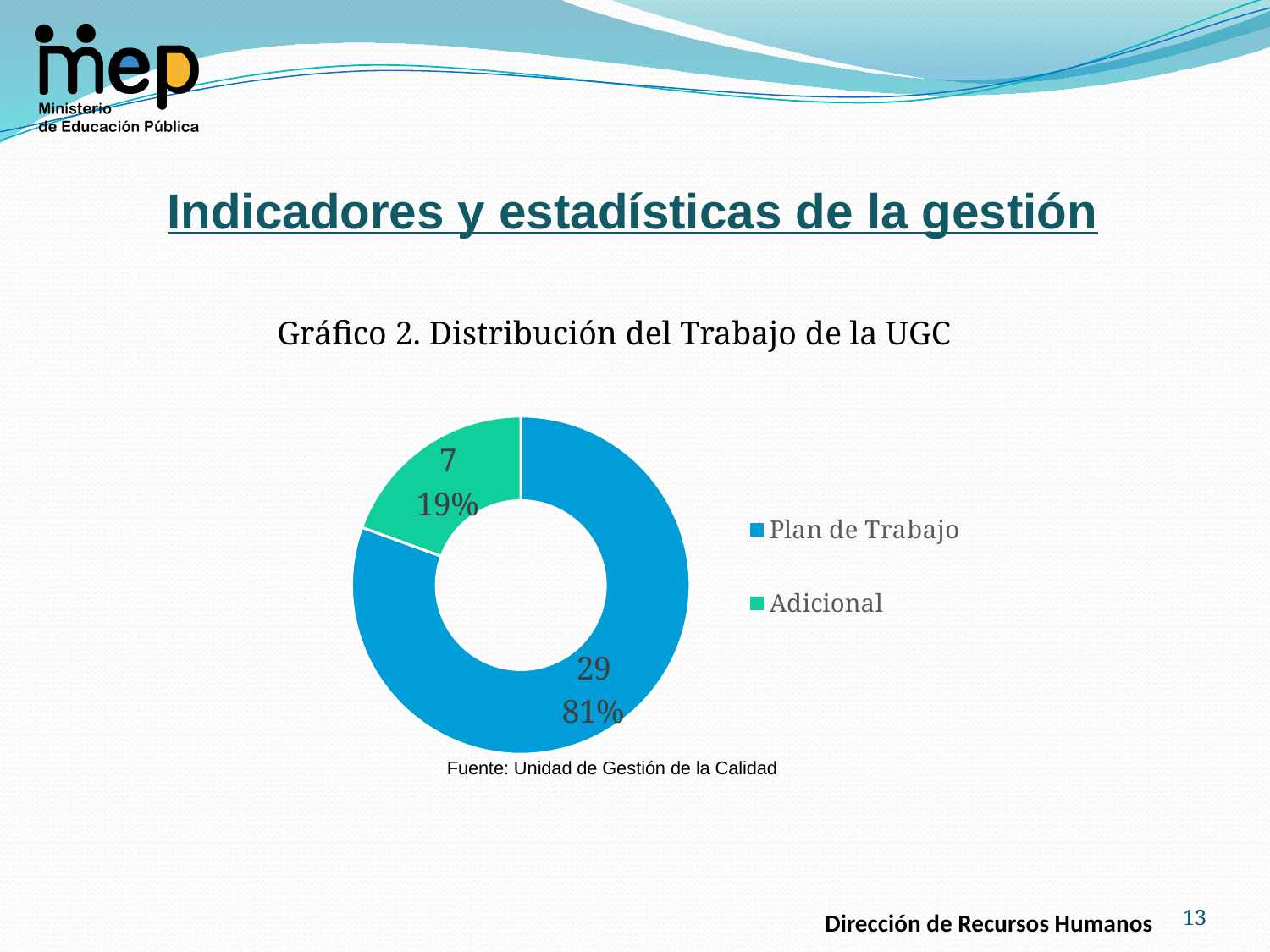
What is the value for Plan de Trabajo? 29 Which category has the largest share? Plan de Trabajo What kind of chart is shown? Doughnut chart What is the total of the two values shown in the chart? 36 Which category has the smallest share? Adicional How many categories does the chart show? 2 What is the value for Adicional? 7 Which is larger, Plan de Trabajo or Adicional? Plan de Trabajo What percentage share does Plan de Trabajo have? 81% What is the difference between the values for Plan de Trabajo and Adicional? 22 What percentage share does Adicional have? 19% What is the title of the chart? Gráfico 2. Distribución del Trabajo de la UGC